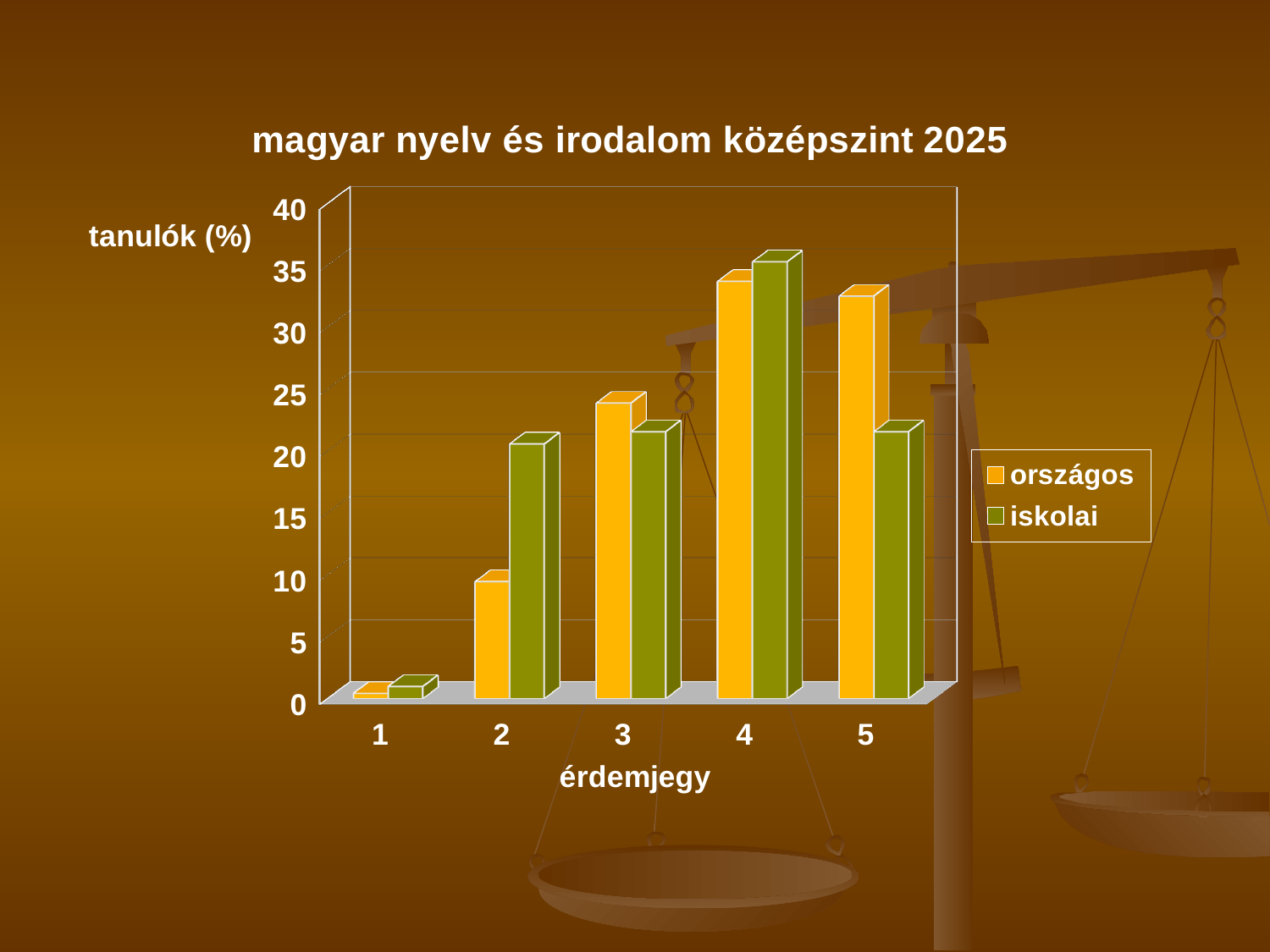
What kind of chart is shown on the slide? bar chart Which érdemjegy has the highest value for the iskolai series? 4 How many categories (érdemjegy values) are shown on the x axis? 5 For érdemjegy 2, which series has the larger value, országos or iskolai? iskolai How many series does the legend list? 2 What is the title of the chart? magyar nyelv és irodalom középszint 2025 For érdemjegy 5, which series has the larger value, országos or iskolai? országos Is the országos value for érdemjegy 1 greater or less than 5? less Is the iskolai value for érdemjegy 5 greater or less than 25? less For érdemjegy 3, which series has the larger value, országos or iskolai? országos Which érdemjegy has the lowest value for the országos series? 1 Is the országos value for érdemjegy 4 greater or less than 30? greater